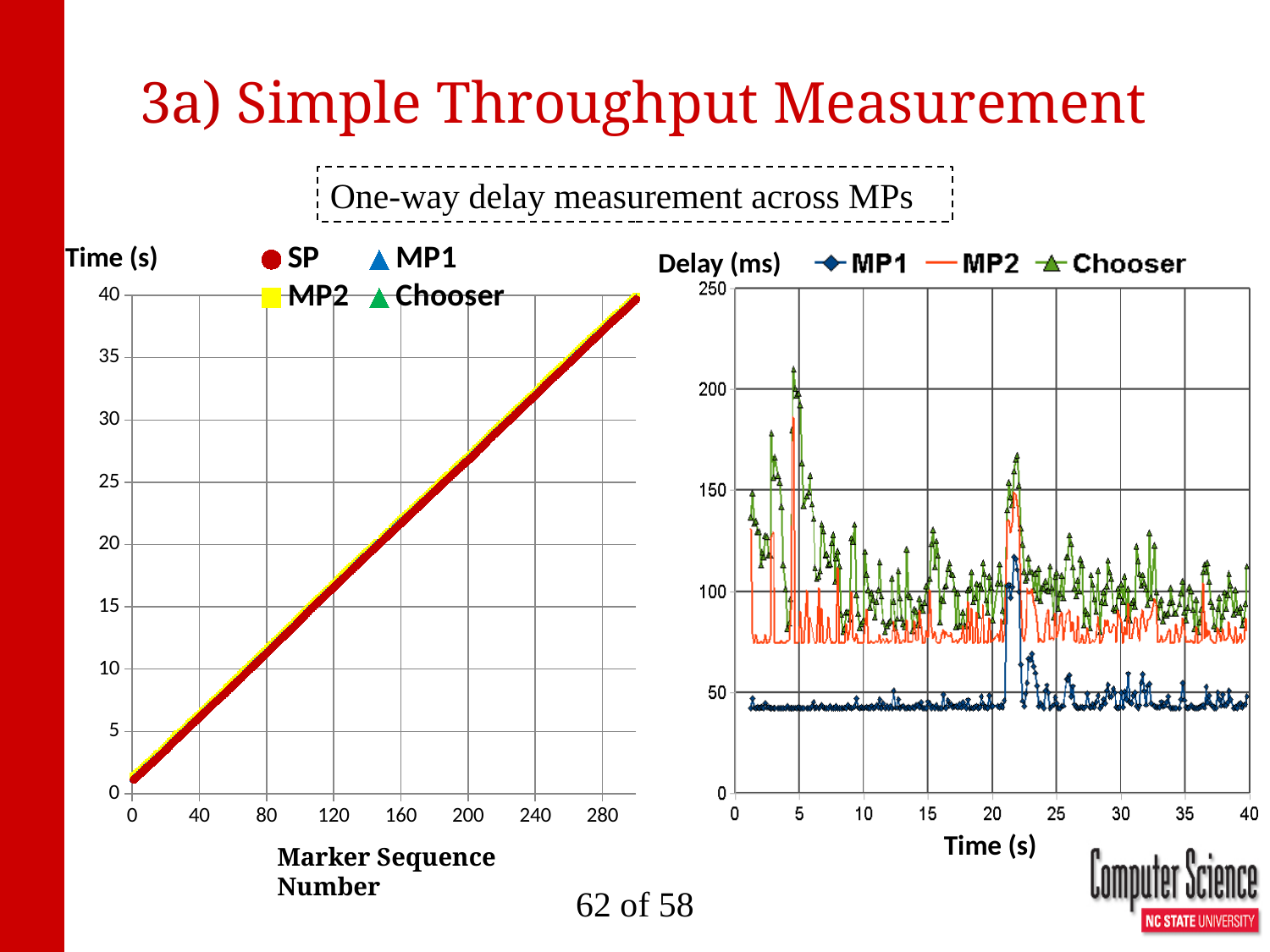
What kind of chart is the right chart showing Delay (ms) over Time (s)? line chart In the right chart, is the Chooser delay at around 5 s greater or less than 150? greater How many series does the legend of the right chart (Delay (ms)) list? 3 In the left chart, do the Time (s) values rise or fall as the Marker Sequence Number increases? rise What is the highest tick value on the y-axis of the right chart (Delay (ms))? 250 What is the x-axis label of the left chart? Marker Sequence Number How many series does the legend of the left chart (Time (s) vs Marker Sequence Number) list? 4 In the right chart, at around 30 s, which series has the larger delay, MP1 or Chooser? Chooser In the right chart, is the MP2 delay at around 10 s greater or less than 100? less In the right chart, which series has the lowest delay values overall? MP1 In the right chart, which series reaches the highest delay value? Chooser In the right chart, is the MP1 delay at around 30 s greater or less than 100? less